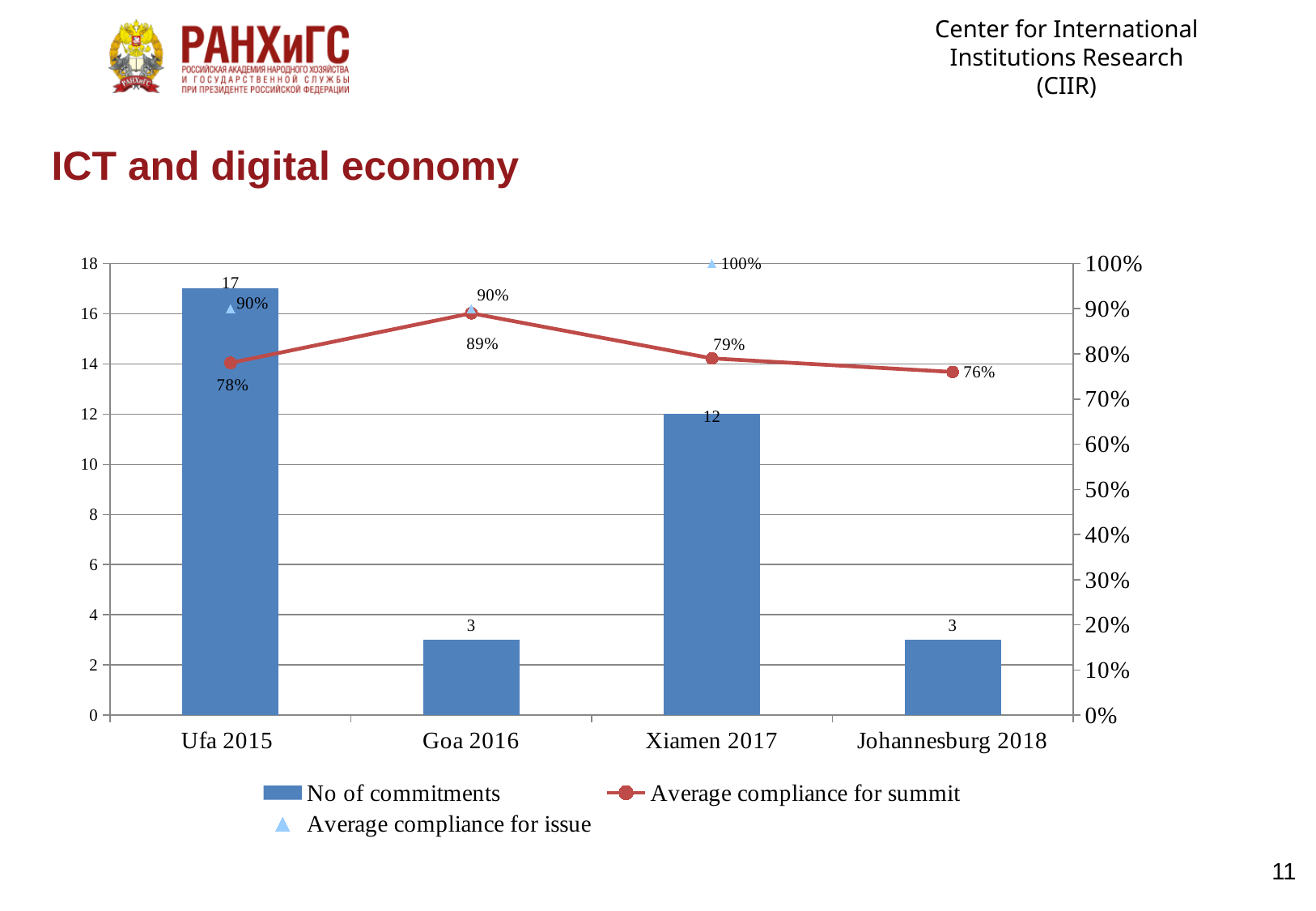
What kind of chart is used to show the number of commitments? Bar chart What is the difference in the number of commitments between Ufa 2015 and Xiamen 2017? 5 How many summits are shown on the x axis? 4 What is the average compliance for summit at Johannesburg 2018? 76% How many series does the legend list? 3 Which summit has the highest number of commitments? Ufa 2015 What is the title of the slide containing the chart? ICT and digital economy Which is larger, the average compliance for summit at Ufa 2015 or at Goa 2016? Goa 2016 What is the average compliance for issue at Xiamen 2017? 100% Which summit has the lowest average compliance for summit? Johannesburg 2018 How many commitments are shown for Ufa 2015? 17 What is the average compliance for summit at Goa 2016? 89%